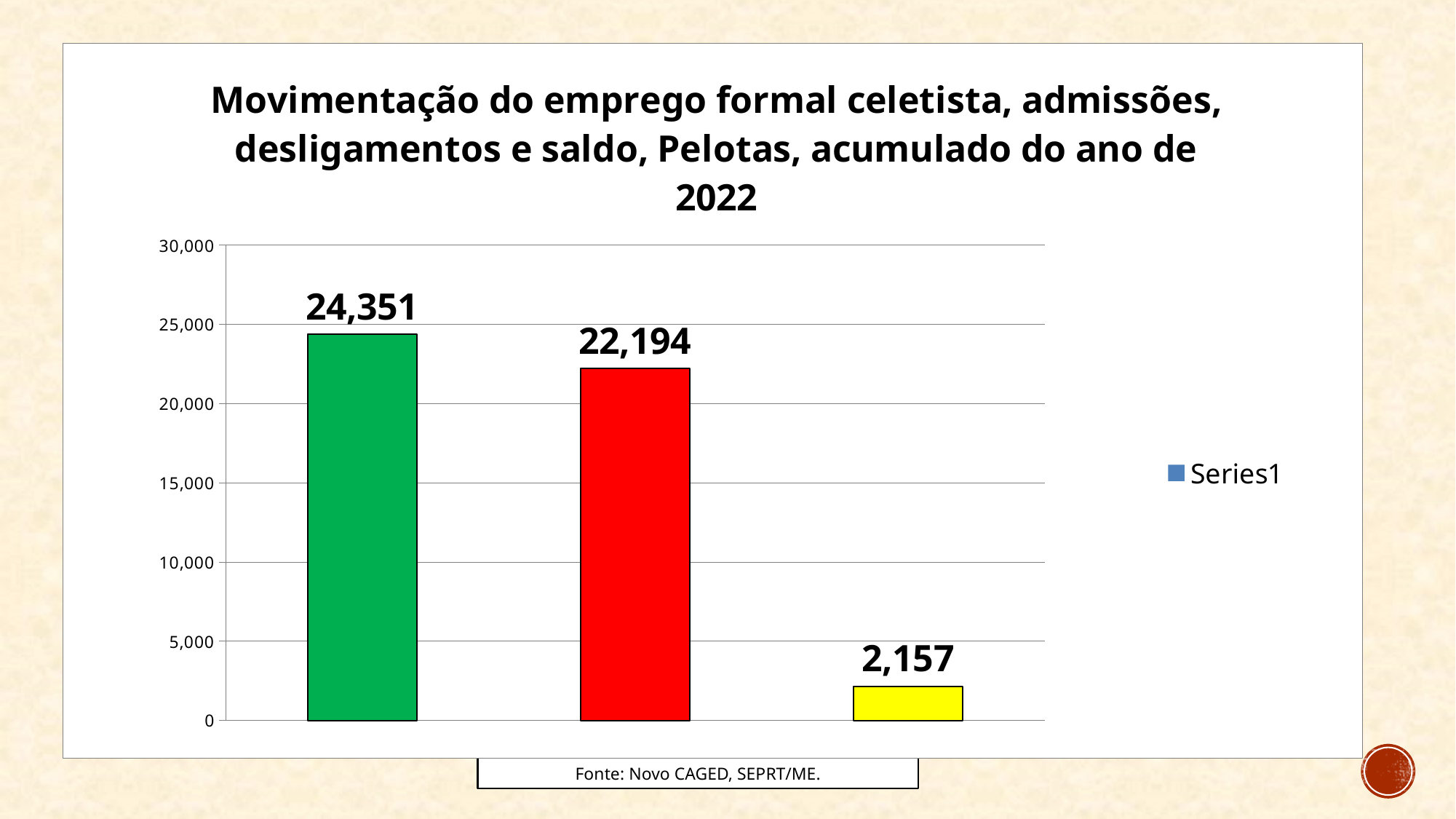
How many series does the legend list? 1 Which bar has the lowest value: the green, red or yellow one? yellow What is the difference between the value of the green bar and the value of the red bar? 2,157 Which bar has the highest value: the green, red or yellow one? green Which is larger, the value of the red bar or the value of the yellow bar? red bar Is the value of the green bar greater or less than 25,000? less What kind of chart is shown on the slide? bar chart How many bars are plotted in the chart? 3 What value is shown on the green bar (the leftmost bar)? 24,351 What value is shown on the red bar (the middle bar)? 22,194 What is the difference between the value of the red bar and the value of the yellow bar? 20,037 What value is shown on the yellow bar (the rightmost bar)? 2,157